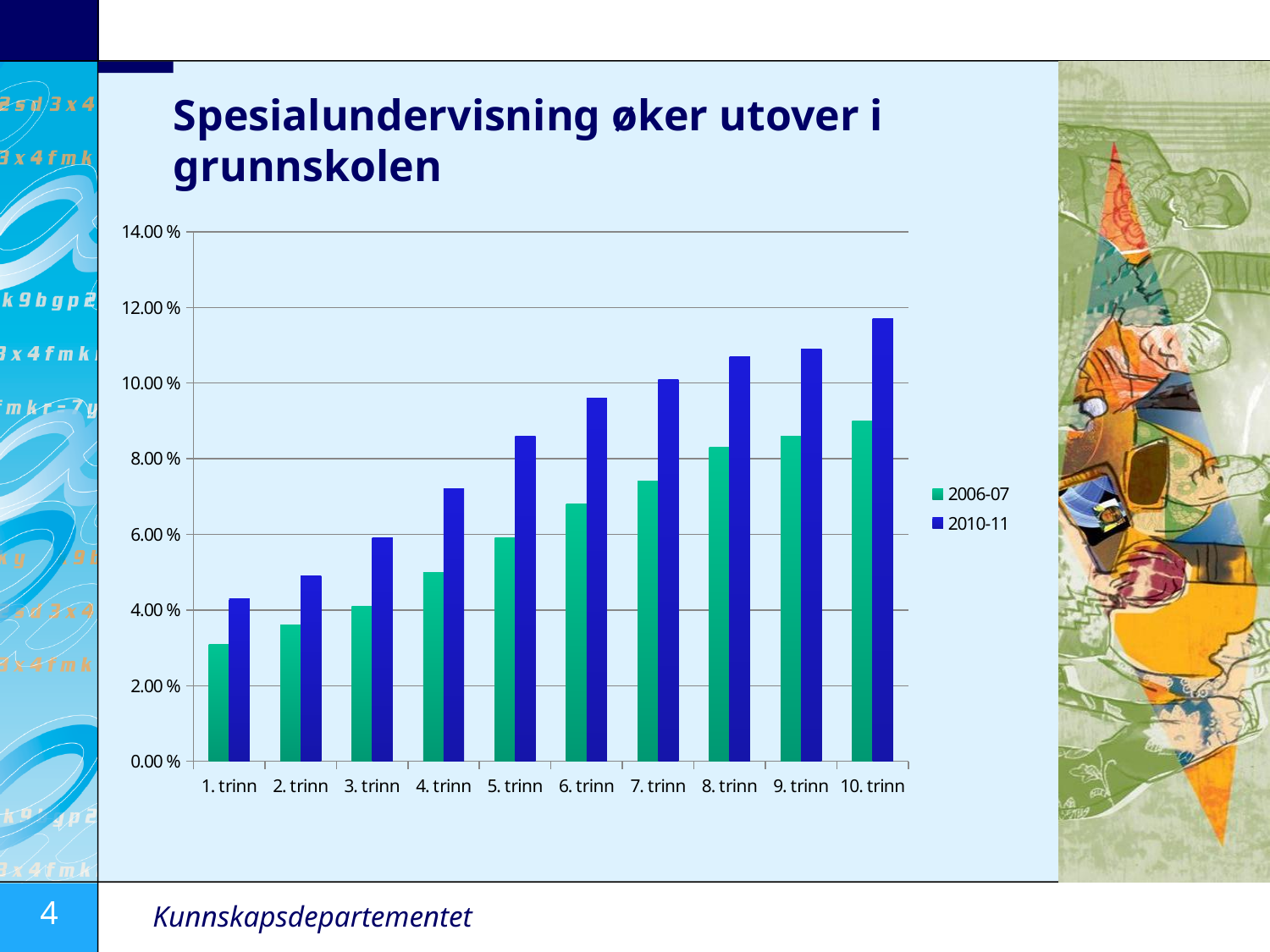
What is the title of the chart slide? Spesialundervisning øker utover i grunnskolen Which grade level has the highest value for 2010-11? 10. trinn For 5. trinn, which series has the larger value, 2006-07 or 2010-11? 2010-11 What kind of chart is shown on the slide? bar chart How many series does the legend list? 2 Is the value for 1. trinn in 2006-07 greater or less than 4.00 %? less Is the value for 10. trinn in 2010-11 greater or less than 10.00 %? greater How many grade levels (trinn) are shown on the x axis? 10 Which grade level has the lowest value for 2006-07? 1. trinn Is the value for 5. trinn in 2010-11 greater or less than 8.00 %? greater Do the values for 2010-11 rise or fall from 1. trinn to 10. trinn? rise Which colour represents the 2006-07 series in the legend? green